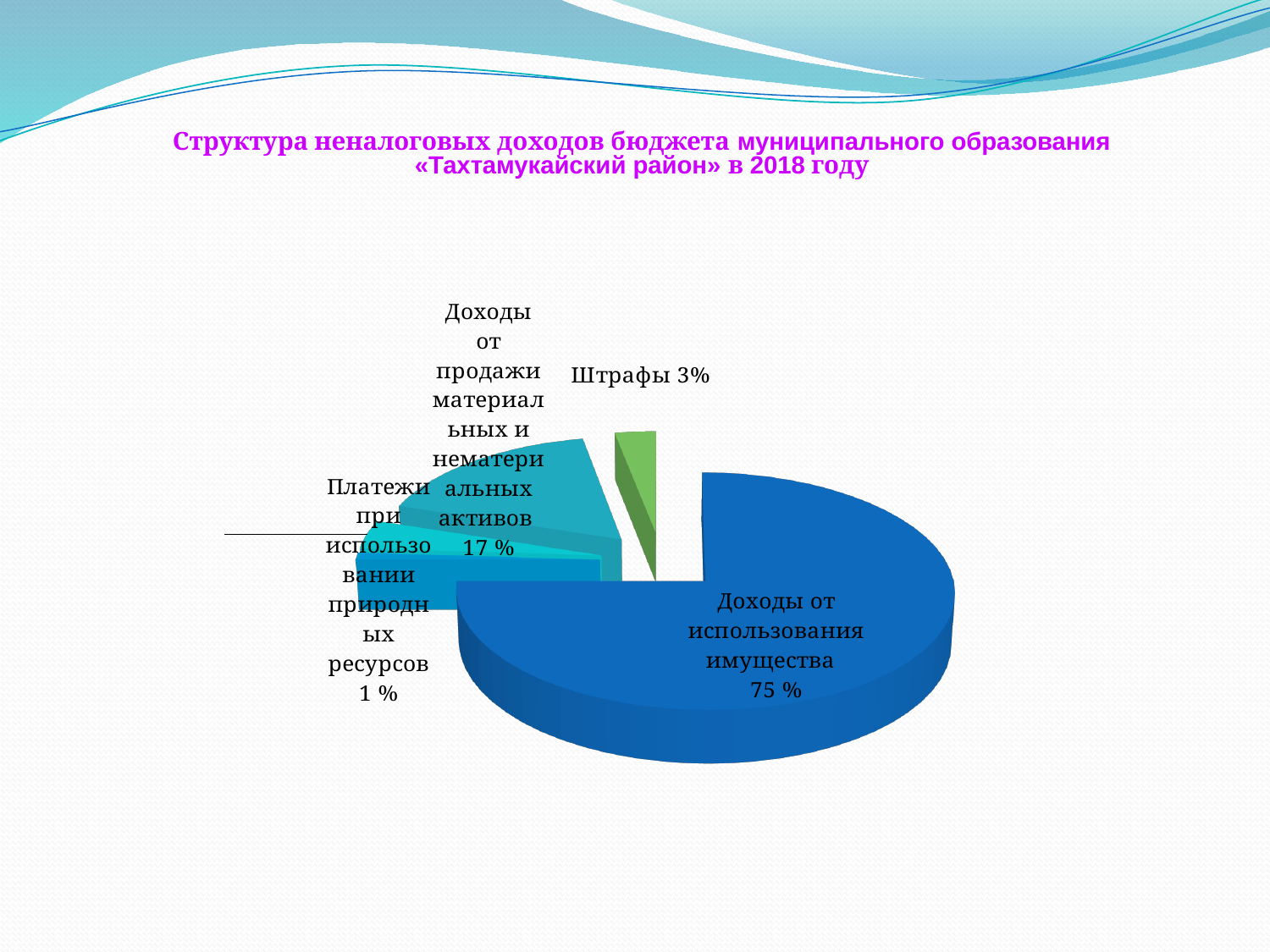
Which category has the smallest slice of the pie? Платежи при использовании природных ресурсов What is the title of the chart on the slide? Структура неналоговых доходов бюджета муниципального образования «Тахтамукайский район» в 2018 году What share is shown for «Доходы от продажи материальных и нематериальных активов»? 17 % What kind of chart is shown on the slide? pie chart What share is shown for «Штрафы»? 3% Which is larger: the share for «Штрафы» or the share for «Платежи при использовании природных ресурсов»? Штрафы Which category has the largest slice of the pie? Доходы от использования имущества How many slices does the pie chart have? 5 What is the difference in percentage points between «Доходы от использования имущества» and «Доходы от продажи материальных и нематериальных активов»? 58 What share of non-tax revenues comes from «Доходы от использования имущества»? 75 % What share is shown for «Платежи при использовании природных ресурсов»? 1 % What colour is the slice for «Штрафы»? green